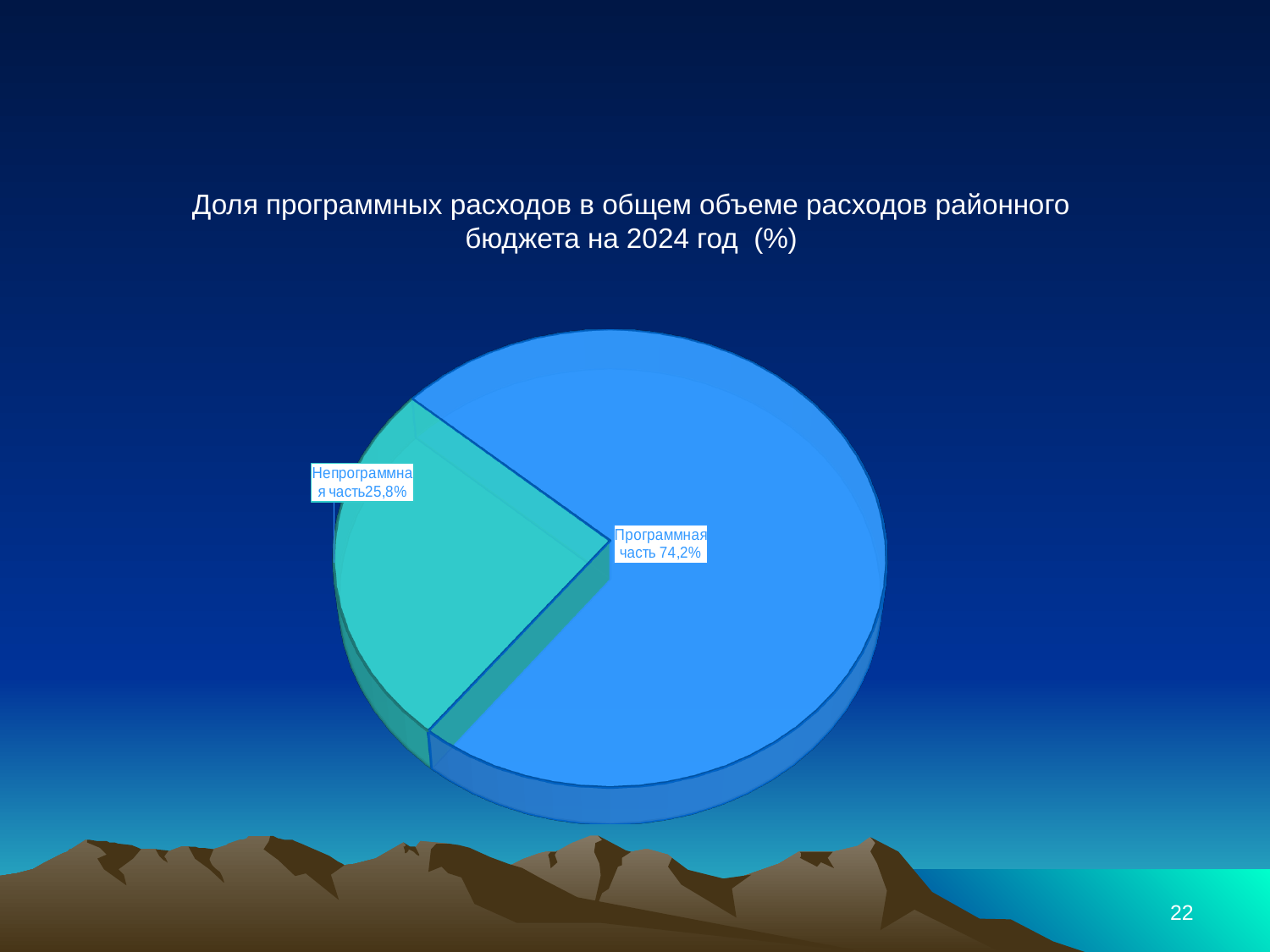
What is the value shown for Непрограммная часть? 25,8% Which slice of the pie is the smallest? Непрограммная часть What is the difference between the Программная часть and Непрограммная часть values? 48,4% Which is larger, Программная часть or Непрограммная часть? Программная часть What is the value shown for Программная часть? 74,2% How many slices does the pie chart have? 2 What is the title of the chart? Доля программных расходов в общем объеме расходов районного бюджета на 2024 год (%) What colour is the Непрограммная часть slice? Teal (green-blue) What share of the pie does Непрограммная часть represent? 25,8% What type of chart is shown on the slide? Pie chart Which slice of the pie is the largest? Программная часть What is the total of the two slice values shown? 100%